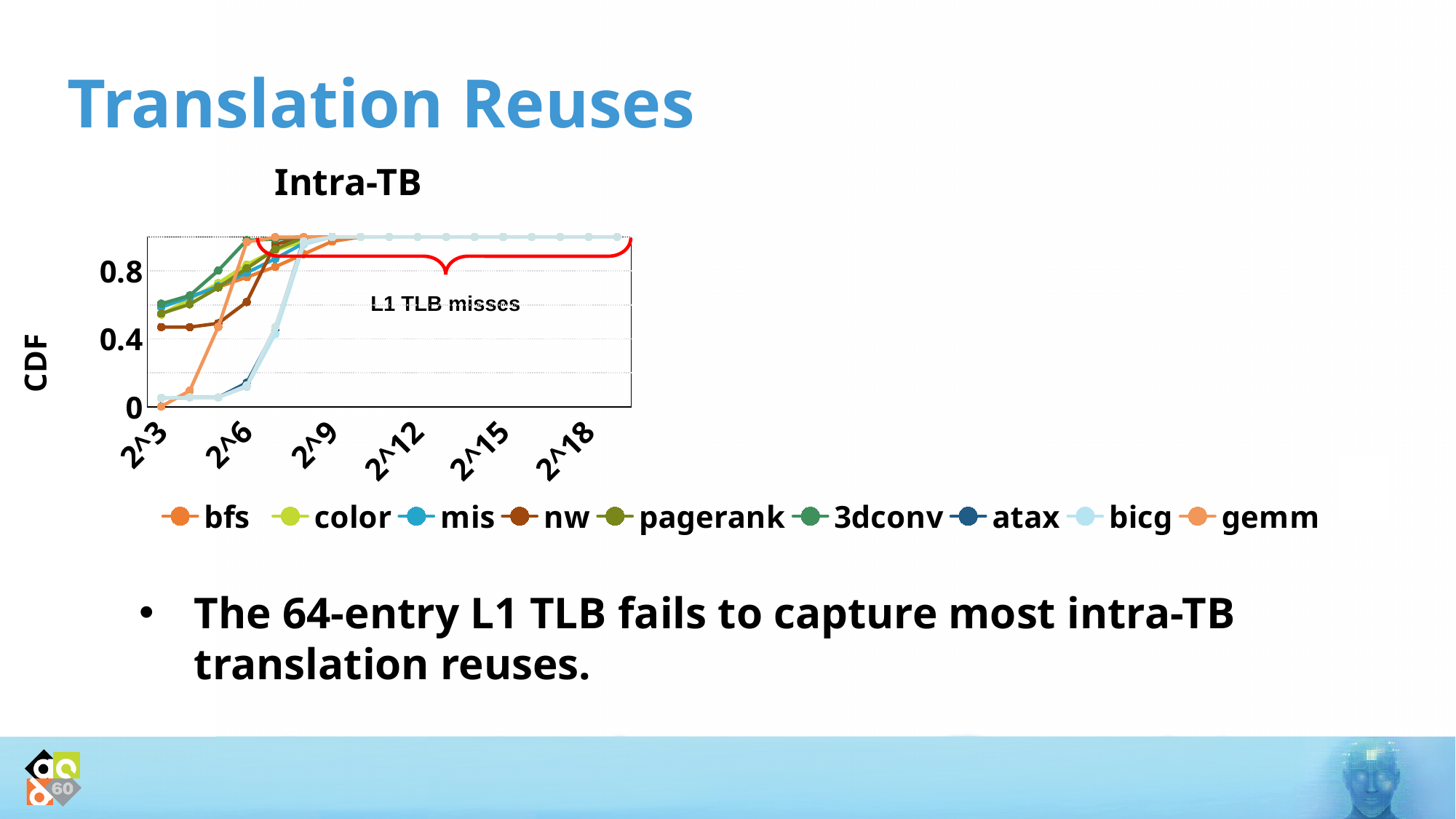
At 2^6, which has the larger CDF value, bicg or nw? nw Is the CDF value for 3dconv at 2^3 greater or less than 0.4? greater Is the CDF value for bfs at 2^3 greater or less than 0.4? greater Is the CDF value for bicg at 2^3 greater or less than 0.4? less What kind of chart is shown on the slide? line chart What is the title of the chart? Intra-TB How many series does the legend of the Intra-TB chart list? 9 Do the CDF values for the series rise or fall as the x axis increases? rise What is the label on the y axis of the chart? CDF